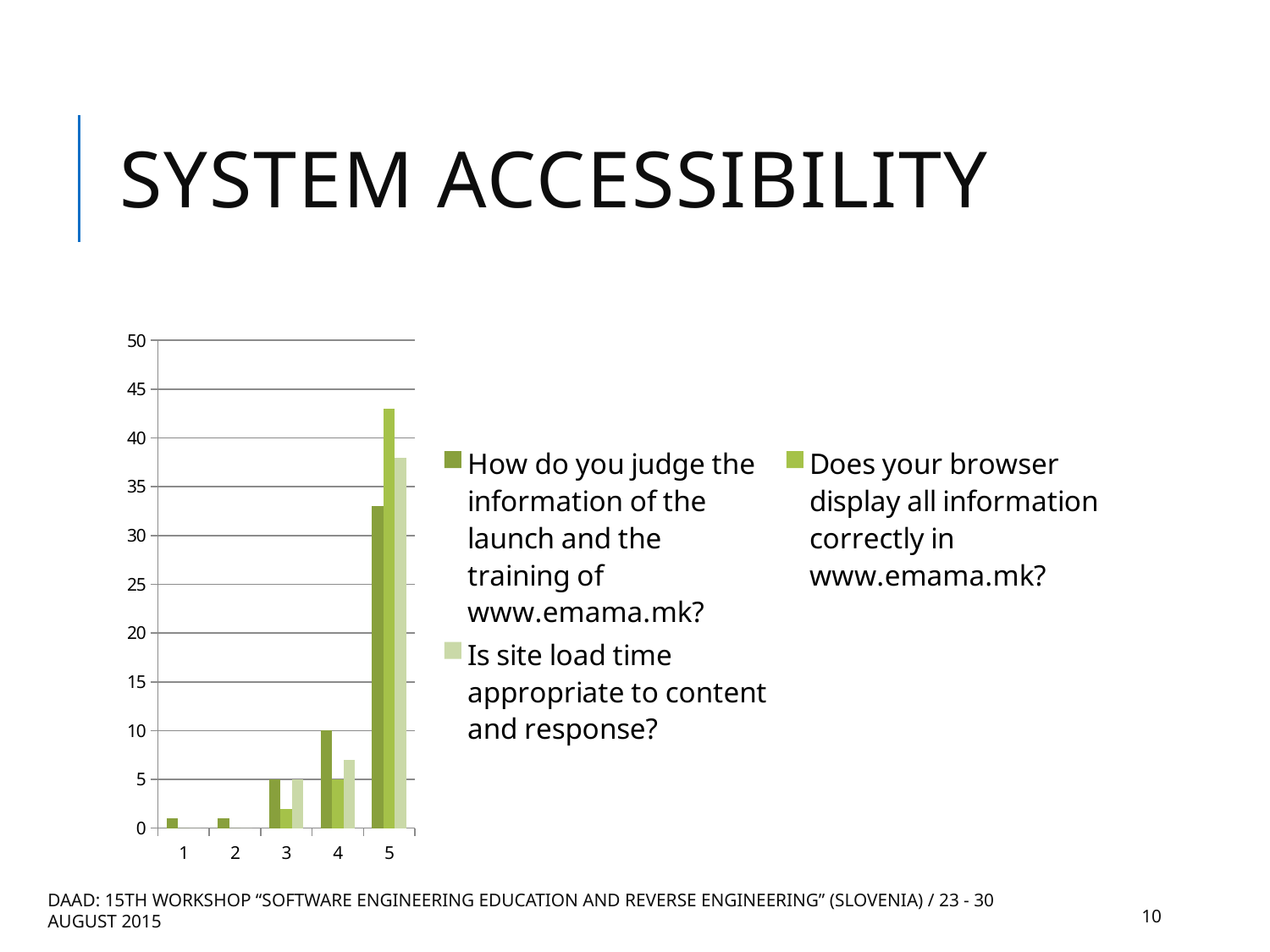
How many series does the legend list? 3 Is the value for category 4 of the series "How do you judge the information of the launch and the training of www.emama.mk?" greater or less than 5? greater Do the values for the series "Does your browser display all information correctly in www.emama.mk?" generally rise or fall from category 1 to category 5? rise At category 4, which series has the larger value: "How do you judge the information of the launch and the training of www.emama.mk?" or "Does your browser display all information correctly in www.emama.mk?"? How do you judge the information of the launch and the training of www.emama.mk? What kind of chart is shown on the slide? Bar chart Is the value for category 5 of the series "How do you judge the information of the launch and the training of www.emama.mk?" greater or less than 35? less At category 5, which series has the larger value: "How do you judge the information of the launch and the training of www.emama.mk?" or "Does your browser display all information correctly in www.emama.mk?"? Does your browser display all information correctly in www.emama.mk? Which category has the highest value for the series "Does your browser display all information correctly in www.emama.mk?"? 5 Is the value for category 5 of the series "Is site load time appropriate to content and response?" greater or less than 35? greater Which series is shown in the darkest green in the legend? How do you judge the information of the launch and the training of www.emama.mk? How many categories are shown on the x axis? 5